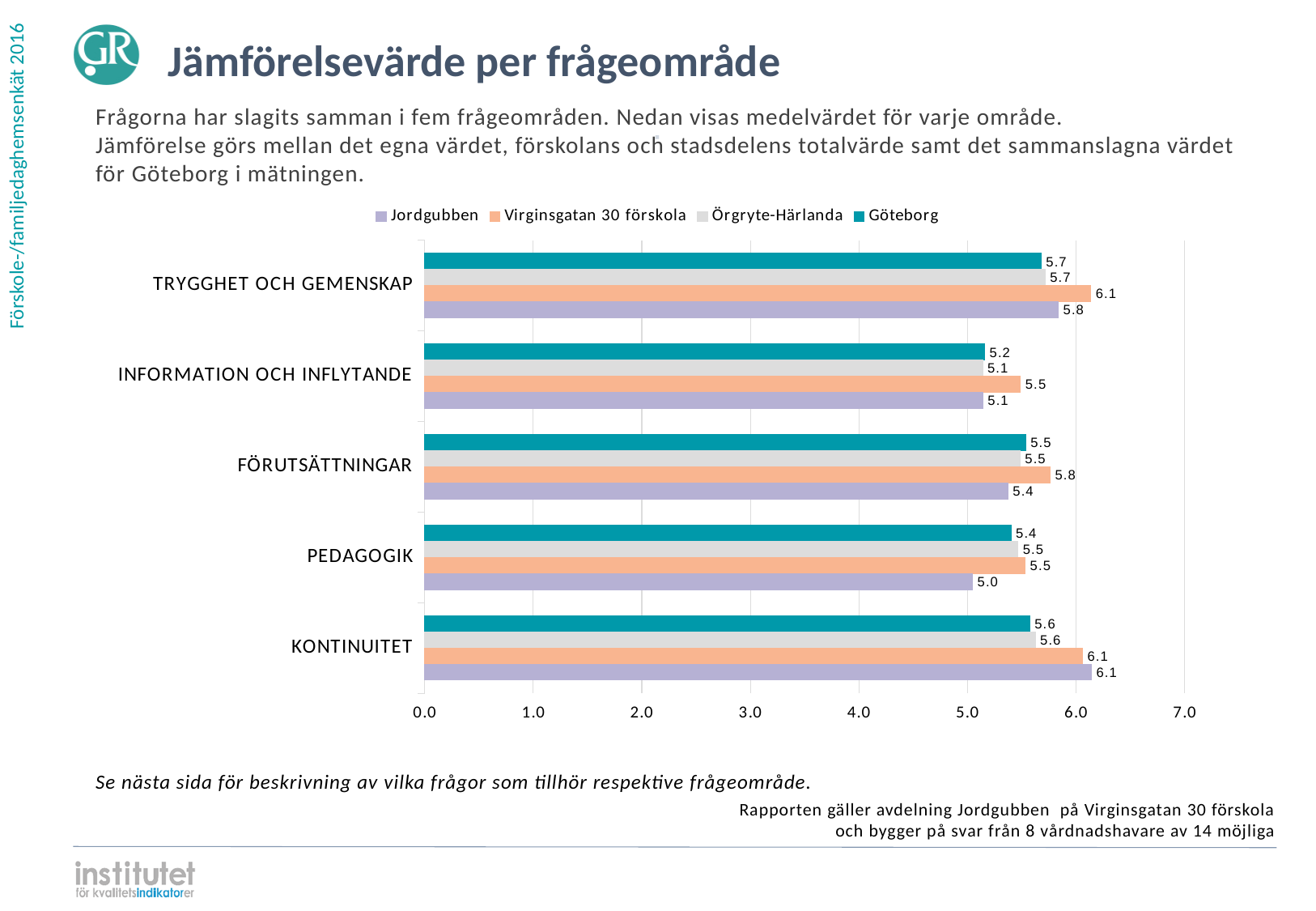
How many categories (frågeområden) are shown on the chart? 5 What is the difference between the Virginsgatan 30 förskola value and the Jordgubben value in the FÖRUTSÄTTNINGAR category? 0.4 What kind of chart is shown on the slide? Bar chart How many series does the legend list? 4 What is the value for Jordgubben in the PEDAGOGIK category? 5.0 What is the value for Örgryte-Härlanda in the KONTINUITET category? 5.6 What is the value for Virginsgatan 30 förskola in the TRYGGHET OCH GEMENSKAP category? 6.1 In which category does Jordgubben have its lowest value? PEDAGOGIK Which is larger in the INFORMATION OCH INFLYTANDE category: the Virginsgatan 30 förskola value or the Jordgubben value? Virginsgatan 30 förskola Which series is shown in teal (dark green) on the chart? Göteborg In which category does Jordgubben have its highest value? KONTINUITET What is the value for Göteborg in the INFORMATION OCH INFLYTANDE category? 5.2